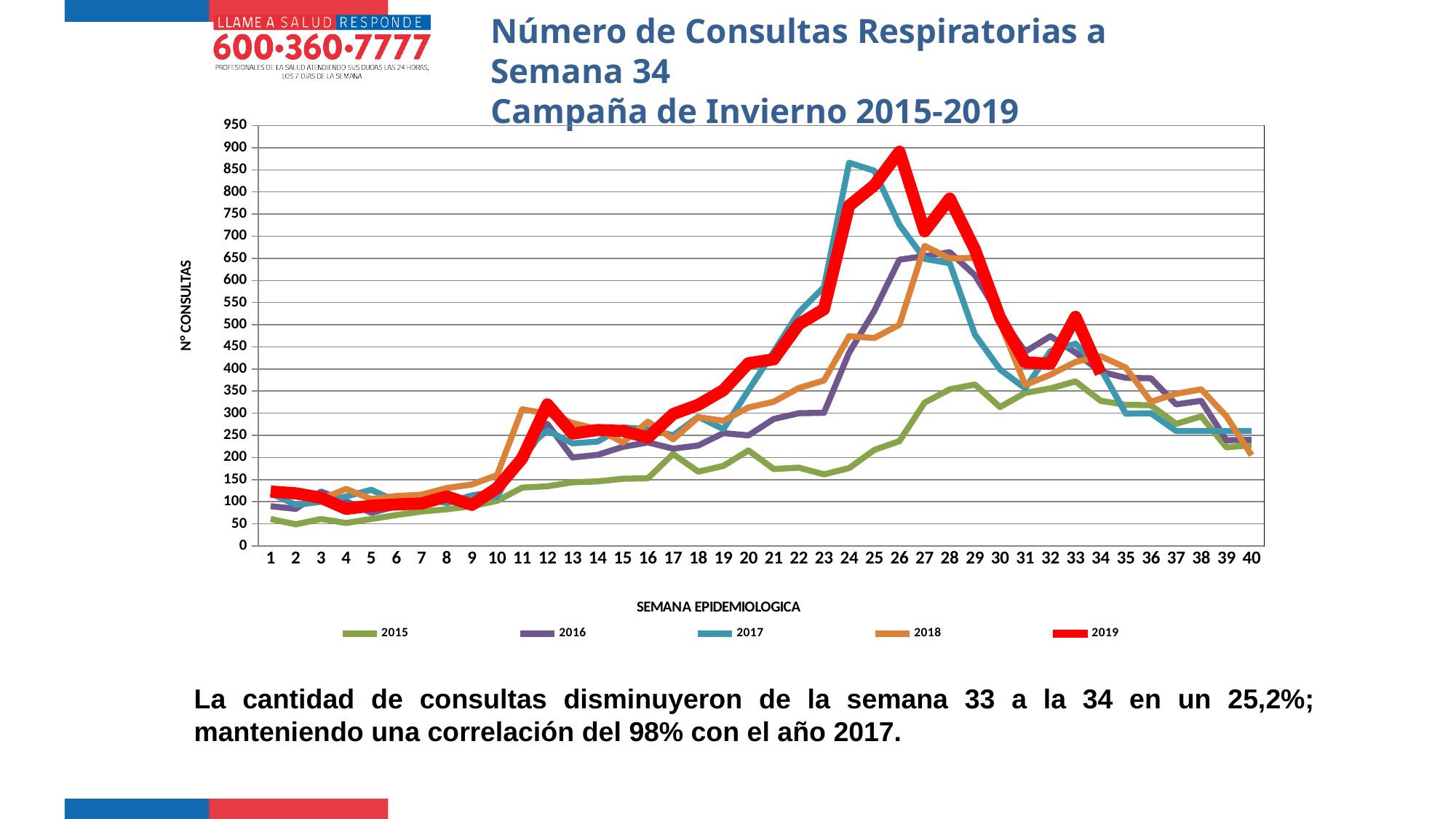
Which colour represents the 2019 series in the legend? red Is the value for 2019 at week 9 greater or less than 150? less Is the value for 2015 at week 26 greater or less than 300? less What kind of chart is shown on the slide? line chart How many series does the legend list? 5 Is the value for 2019 at week 26 greater or less than 850? greater At week 26, which series is higher, 2019 or 2015? 2019 Which year's series has the lowest peak value? 2015 Does the 2019 series rise or fall overall from week 26 to week 34? fall How many epidemiological weeks are shown on the x axis? 40